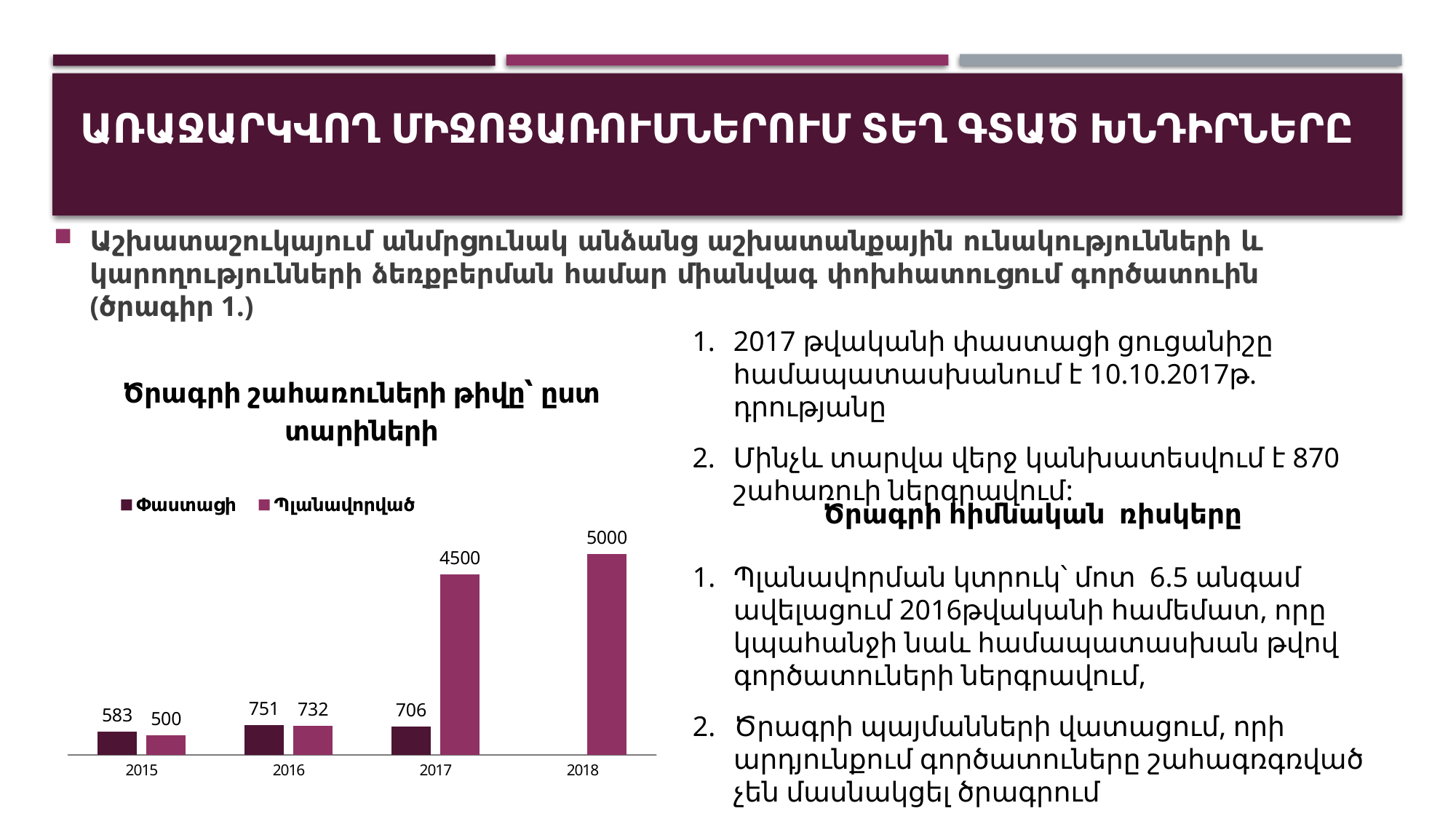
What is the Փաստացի value for 2015? 583 How many series does the legend list? 2 Which is larger for 2016, the Փաստացի value or the Պլանավորված value? Փաստացի Which year has the lowest Պլանավորված value? 2015 What is the Պլանավորված value for 2017? 4500 Which year has the lowest Փաստացի value? 2015 What is the difference between the Պլանավորված and Փաստացի values for 2017? 3794 What is the Փաստացի value for 2016? 751 What is the Պլանավորված value for 2018? 5000 Which year has the highest Պլանավորված value? 2018 What kind of chart is shown on the slide? bar chart How many years are shown on the x axis? 4